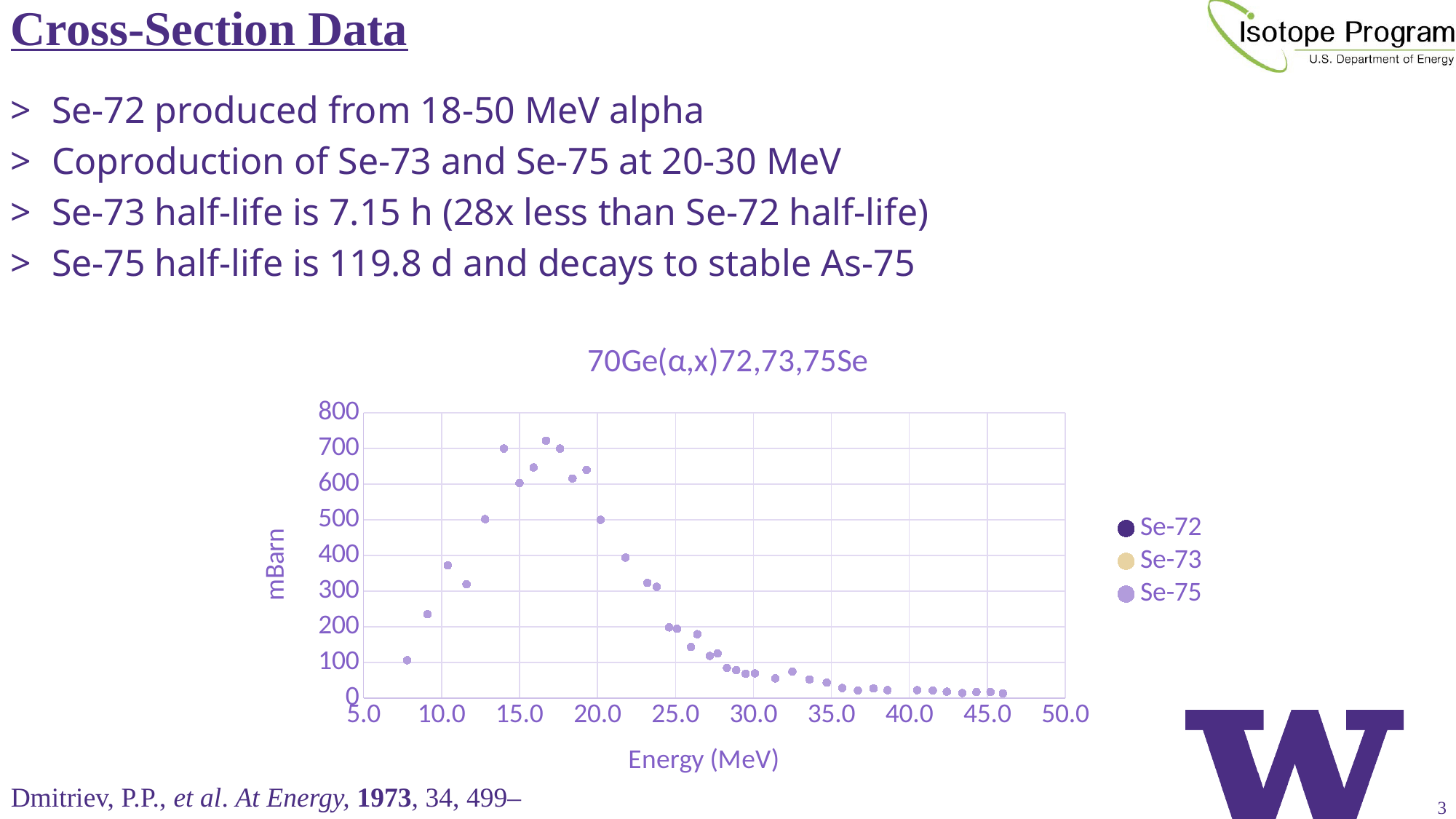
What is the label of the chart's y axis? mBarn Is the highest plotted value in the chart greater or less than 600 mBarn? greater Do the plotted values rise or fall as energy increases from 20 MeV to 45 MeV? fall What kind of chart is shown on the slide? scatter chart Is the plotted value at around 45 MeV greater or less than 100 mBarn? less Is the plotted value at the lowest energy (around 7.5 MeV) greater or less than 200 mBarn? less How many series does the chart's legend list? 3 Which is larger, the plotted value at around 15 MeV or the plotted value at around 30 MeV? around 15 MeV What is the maximum value shown on the chart's y axis? 800 What is the title of the chart? 70Ge(α,x)72,73,75Se Do the plotted values rise or fall as energy increases from 7.5 MeV to 15 MeV? rise